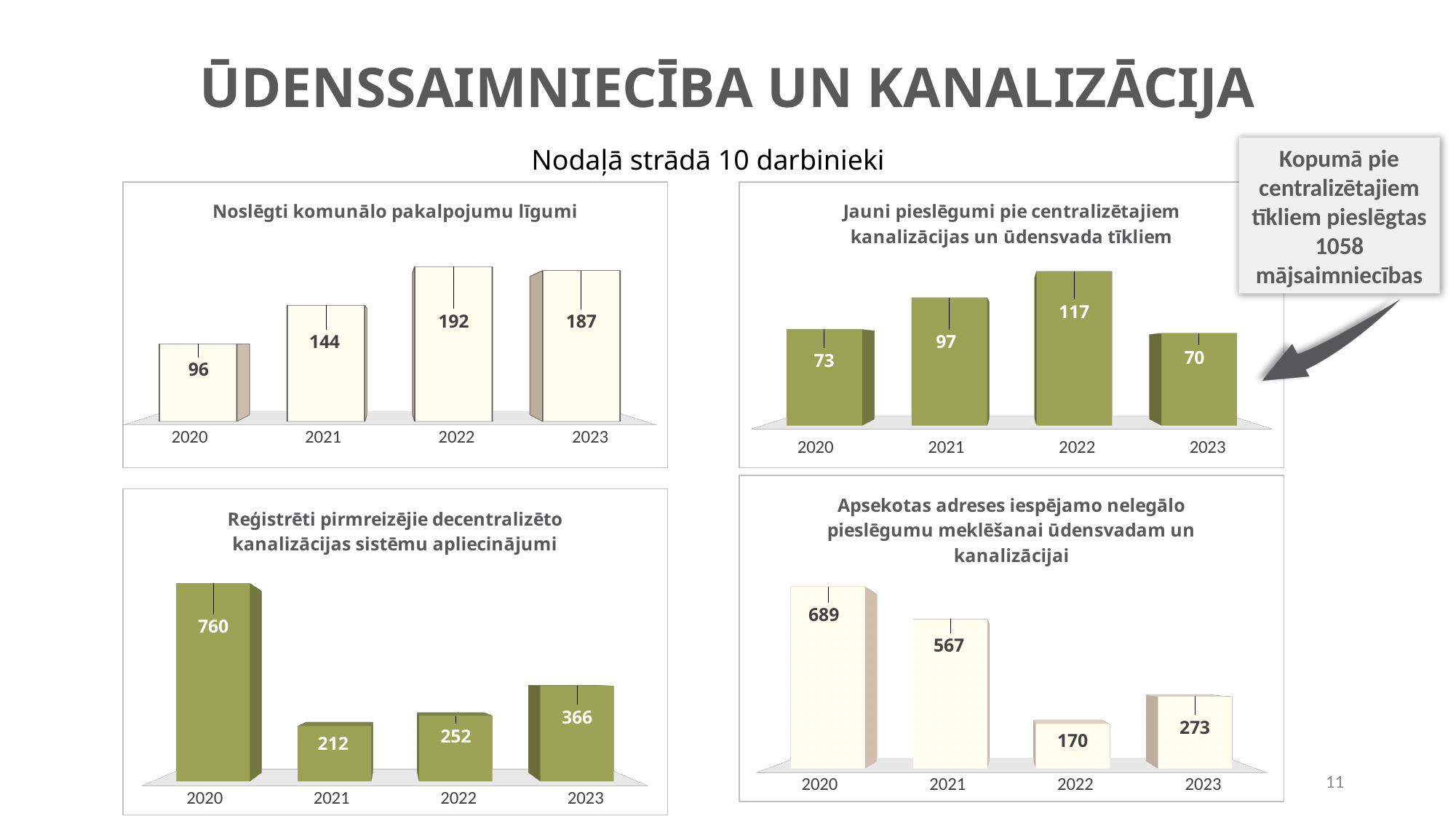
In the chart titled "Jauni pieslēgumi pie centralizētajiem kanalizācijas un ūdensvada tīkliem", what is the value for 2021? 97 In the chart titled "Reģistrēti pirmreizējie decentralizēto kanalizācijas sistēmu apliecinājumi", what is the difference between the values for 2023 and 2022? 114 In the chart titled "Reģistrēti pirmreizējie decentralizēto kanalizācijas sistēmu apliecinājumi", what is the value for 2020? 760 How many years are shown on the x axis of the chart titled "Apsekotas adreses iespējamo nelegālo pieslēgumu meklēšanai ūdensvadam un kanalizācijai"? 4 In the chart titled "Apsekotas adreses iespējamo nelegālo pieslēgumu meklēšanai ūdensvadam un kanalizācijai", which year has the highest value? 2020 In the chart titled "Noslēgti komunālo pakalpojumu līgumi", what is the difference between the values for 2022 and 2021? 48 What kind of chart is the chart titled "Reģistrēti pirmreizējie decentralizēto kanalizācijas sistēmu apliecinājumi"? Bar chart In the chart titled "Noslēgti komunālo pakalpojumu līgumi", which year has the lowest value? 2020 In the chart titled "Apsekotas adreses iespējamo nelegālo pieslēgumu meklēšanai ūdensvadam un kanalizācijai", what is the value for 2022? 170 In the chart titled "Noslēgti komunālo pakalpojumu līgumi", what is the value for 2022? 192 In the chart titled "Jauni pieslēgumi pie centralizētajiem kanalizācijas un ūdensvada tīkliem", which year has the highest value? 2022 In the chart titled "Jauni pieslēgumi pie centralizētajiem kanalizācijas un ūdensvada tīkliem", is the value for 2020 larger or the value for 2023? 2020